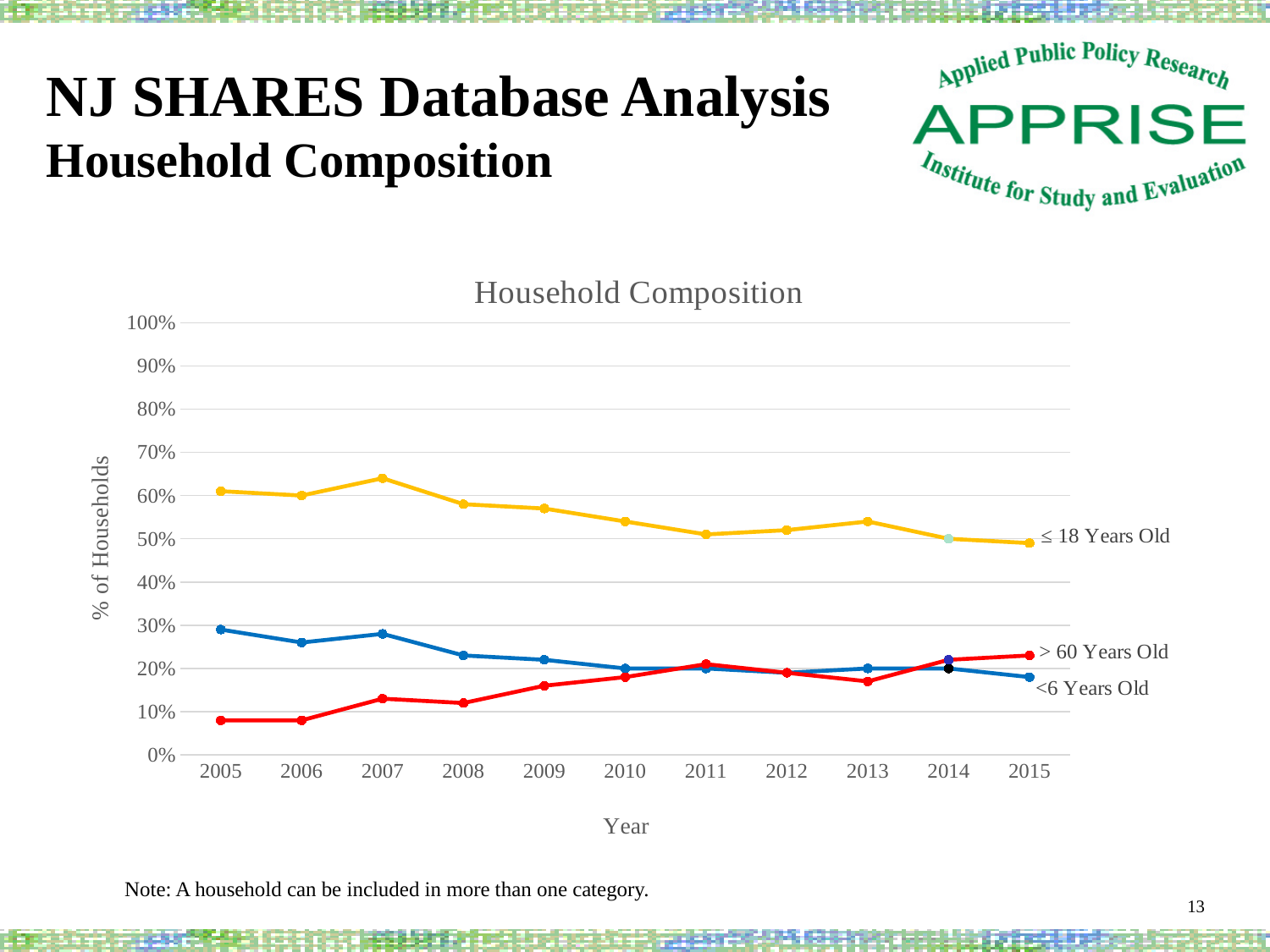
How many years are shown on the x axis of the Household Composition chart? 11 Which series has the lowest value in 2005? > 60 Years Old Is the value for <6 Years Old in 2005 greater or less than 20%? greater Does the > 60 Years Old series generally rise or fall from 2005 to 2015? rise How many series are plotted in the Household Composition chart? 3 Is the value for > 60 Years Old in 2005 greater or less than 10%? less In 2015, which is larger: > 60 Years Old or <6 Years Old? > 60 Years Old Does the ≤ 18 Years Old series generally rise or fall from 2005 to 2015? fall Which series has the highest value in 2005? ≤ 18 Years Old What kind of chart is shown on the slide? line chart What is the x-axis title of the Household Composition chart? Year Is the value for ≤ 18 Years Old in 2007 greater or less than 60%? greater